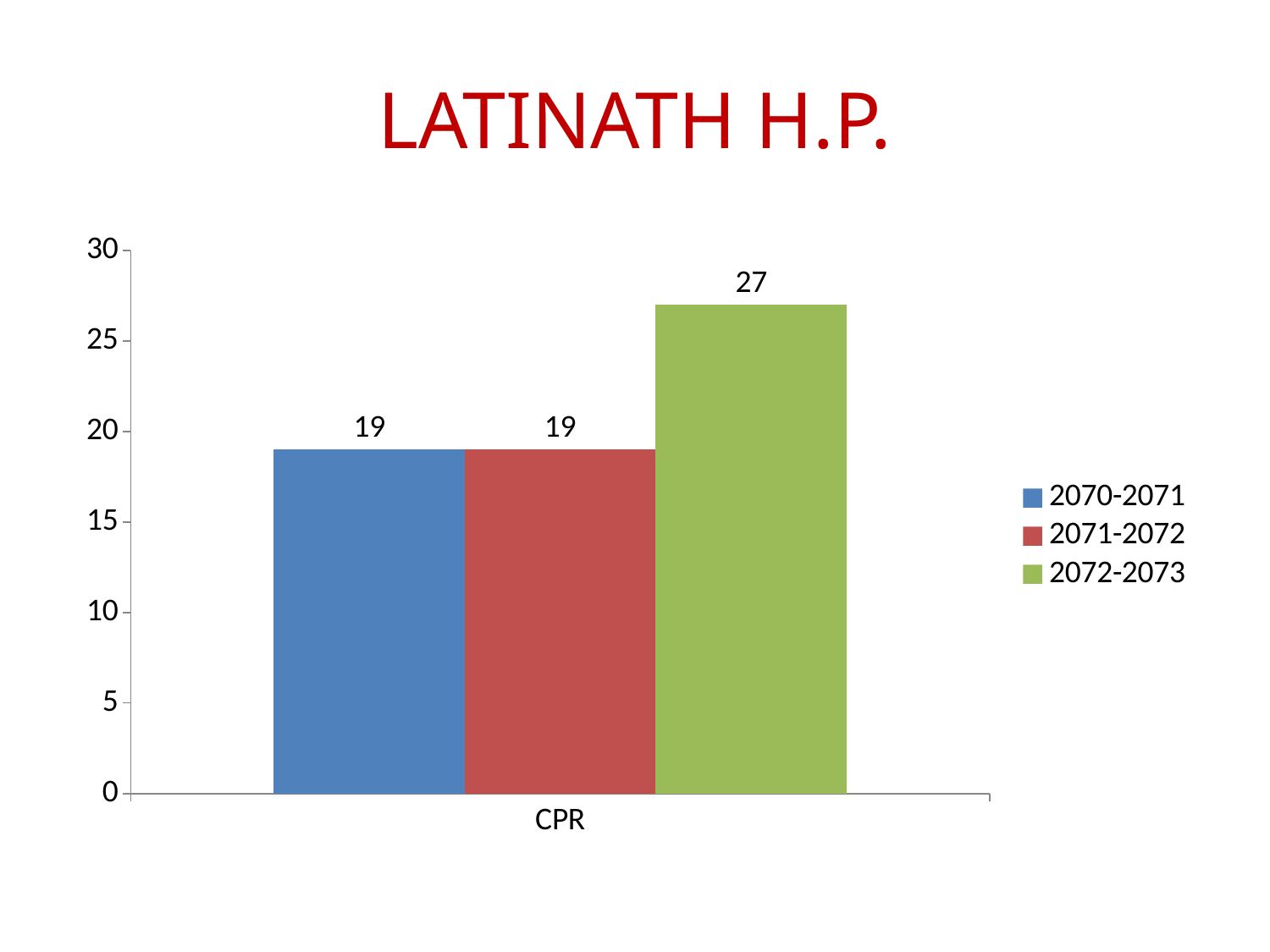
What kind of chart is shown on the slide? bar chart What is the CPR value for 2072-2073? 27 What is the category label on the x axis? CPR What is the title of the slide? LATINATH H.P. Is the CPR value for 2072-2073 greater or less than 25? greater Which series has the highest CPR value? 2072-2073 What is the difference between the CPR values for 2072-2073 and 2071-2072? 8 What is the CPR value for 2070-2071? 19 What is the CPR value for 2071-2072? 19 Is the CPR value for 2070-2071 greater or less than 20? less How many series does the legend list? 3 Which is larger, the CPR value for 2072-2073 or for 2070-2071? 2072-2073